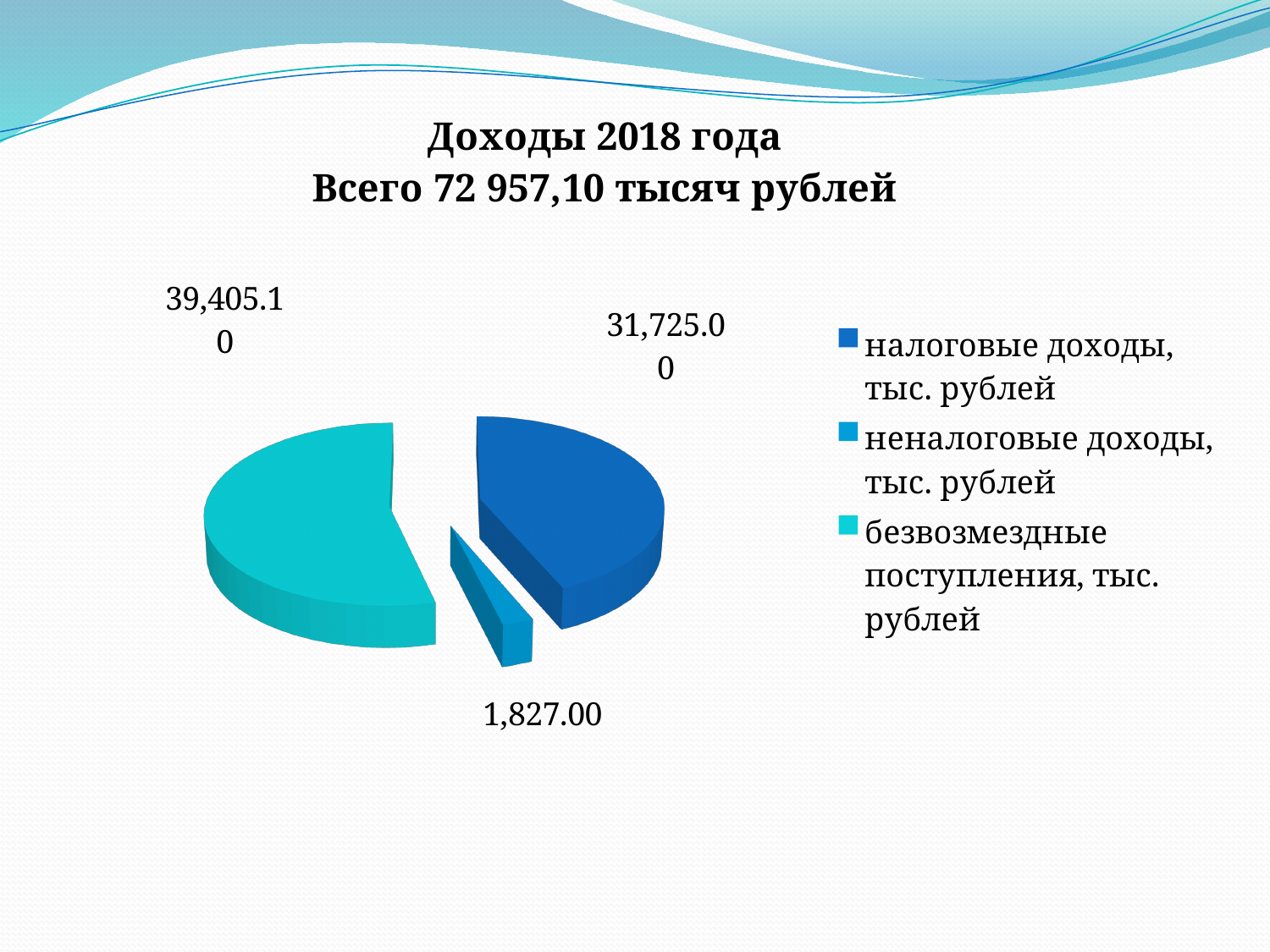
What is the value for налоговые доходы, тыс. рублей? 31,725.00 What type of chart is shown on the slide? pie chart What is the value for безвозмездные поступления, тыс. рублей? 39,405.10 What is the difference between безвозмездные поступления and налоговые доходы? 7,680.10 Which category has the largest slice of the pie? безвозмездные поступления, тыс. рублей Which is larger, налоговые доходы or неналоговые доходы? налоговые доходы How many slices does the pie chart have? 3 Which category has the smallest slice of the pie? неналоговые доходы, тыс. рублей Which colour represents безвозмездные поступления in the legend? teal (light blue-green) What is the difference between налоговые доходы and неналоговые доходы? 29,898.00 What total amount is stated in the chart title? 72 957,10 тысяч рублей What is the value for неналоговые доходы, тыс. рублей? 1,827.00